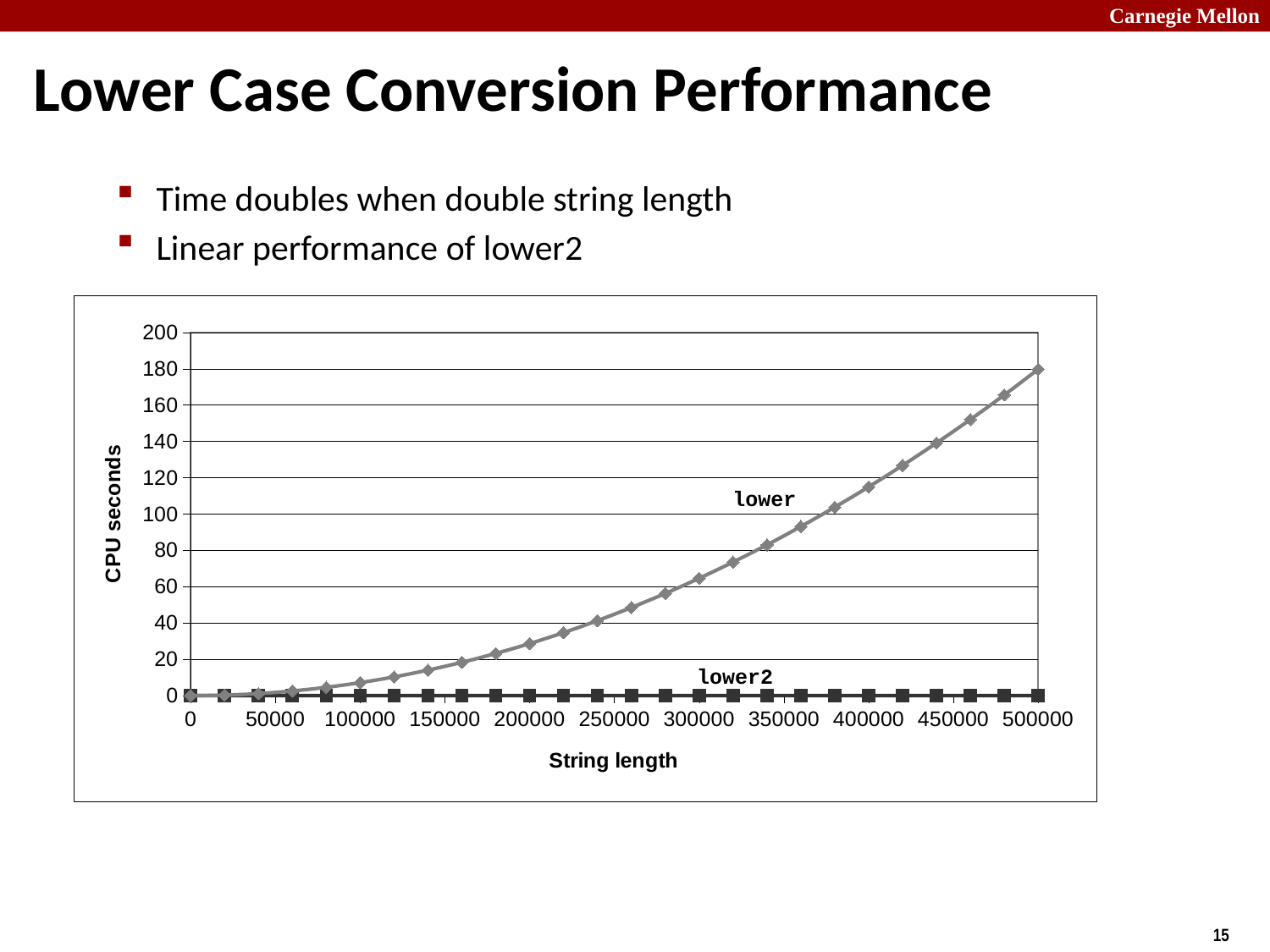
Which series has the higher CPU seconds at a string length of 500000? lower What is the label of the y axis? CPU seconds Which series stays nearly flat near 0 CPU seconds across all string lengths? lower2 Is the value of the lower series at a string length of 400000 greater or less than 100? greater Is the value of the lower2 series at a string length of 500000 greater or less than 20? less What is the maximum value shown on the y axis? 200 Is the value of the lower series at a string length of 250000 greater or less than 60? less How many series are plotted in the chart? 2 Does the CPU time for the lower series rise or fall as string length increases? rise What are the names of the two series plotted in the chart? lower and lower2 What type of chart is shown on the slide? line chart